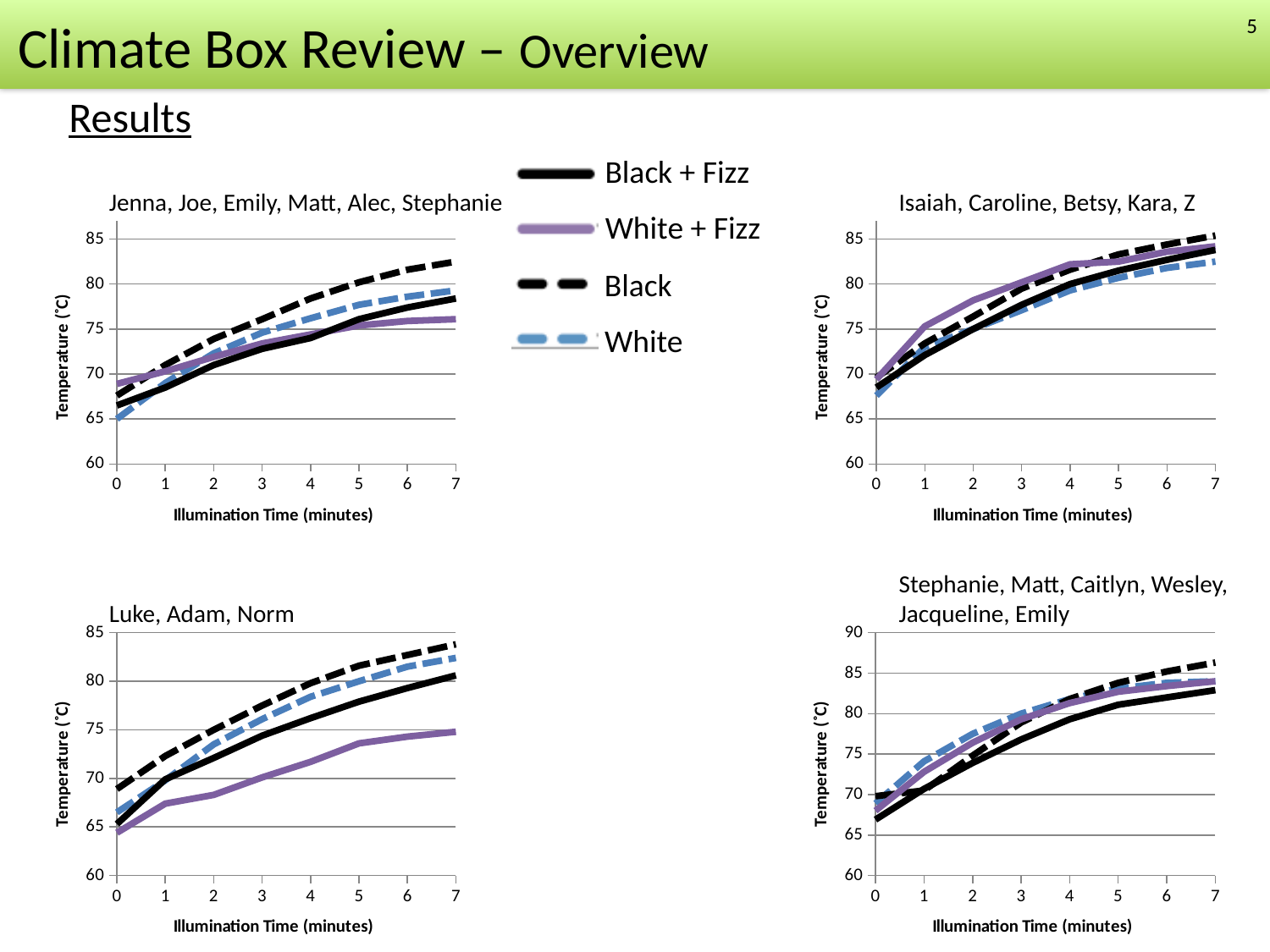
In the chart titled "Stephanie, Matt, Caitlyn, Wesley, Jacqueline, Emily", which series has the lowest temperature at 7 minutes? Black + Fizz In the chart titled "Luke, Adam, Norm", which series has the lowest temperature at 7 minutes? White + Fizz In the chart titled "Stephanie, Matt, Caitlyn, Wesley, Jacqueline, Emily", does the temperature of the Black series rise or fall as illumination time increases? Rise In the chart titled "Jenna, Joe, Emily, Matt, Alec, Stephanie", is the temperature of the White + Fizz series at 7 minutes greater or less than 80? less In the chart titled "Isaiah, Caroline, Betsy, Kara, Z", is the temperature of the White series at 7 minutes greater or less than 85? less In the chart titled "Isaiah, Caroline, Betsy, Kara, Z", which series has the lowest temperature at 7 minutes? White In the chart titled "Luke, Adam, Norm", is the temperature of the Black series at 7 minutes greater or less than 80? greater In the chart titled "Jenna, Joe, Emily, Matt, Alec, Stephanie", which series has the highest temperature at 7 minutes? Black How many series does the shared legend list for the charts on this slide? 4 In the chart titled "Luke, Adam, Norm", which is higher at 7 minutes: the Black + Fizz series or the White + Fizz series? Black + Fizz What kind of chart is the chart titled "Luke, Adam, Norm"? Line chart What is the label of the x axis on the chart titled "Isaiah, Caroline, Betsy, Kara, Z"? Illumination Time (minutes)